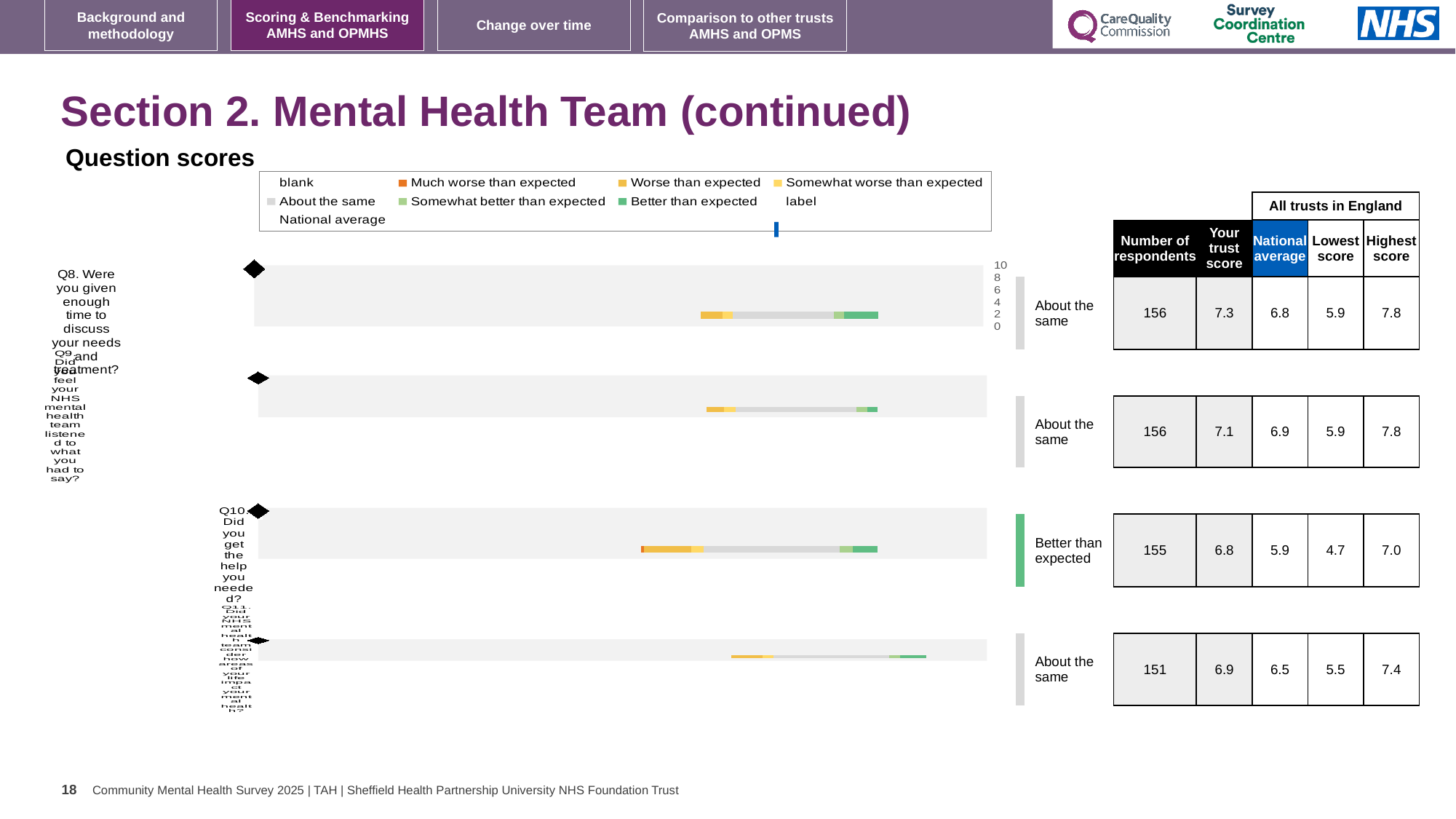
What is the Highest score across all trusts in England for Q11? 7.4 Which question is rated 'Better than expected' on this slide? Q10 What is the difference between the highest score and the lowest score for Q10? 2.3 How many respondents are listed for Q11? 151 For Q9, which is larger: the trust score or the national average? Your trust score Which question has the lowest 'Lowest score' value in the table? Q10 Which question has the highest 'Your trust score' on this slide? Q8 What is the 'Your trust score' value for Q8 (Were you given enough time to discuss your needs and treatment?)? 7.3 What type of chart is used to show the question scores? Bar chart What is the difference between the trust score and the national average for Q8? 0.5 What is the National average score for Q10 (Did you get the help you needed?)? 5.9 How many question bar charts are shown on this slide? 4